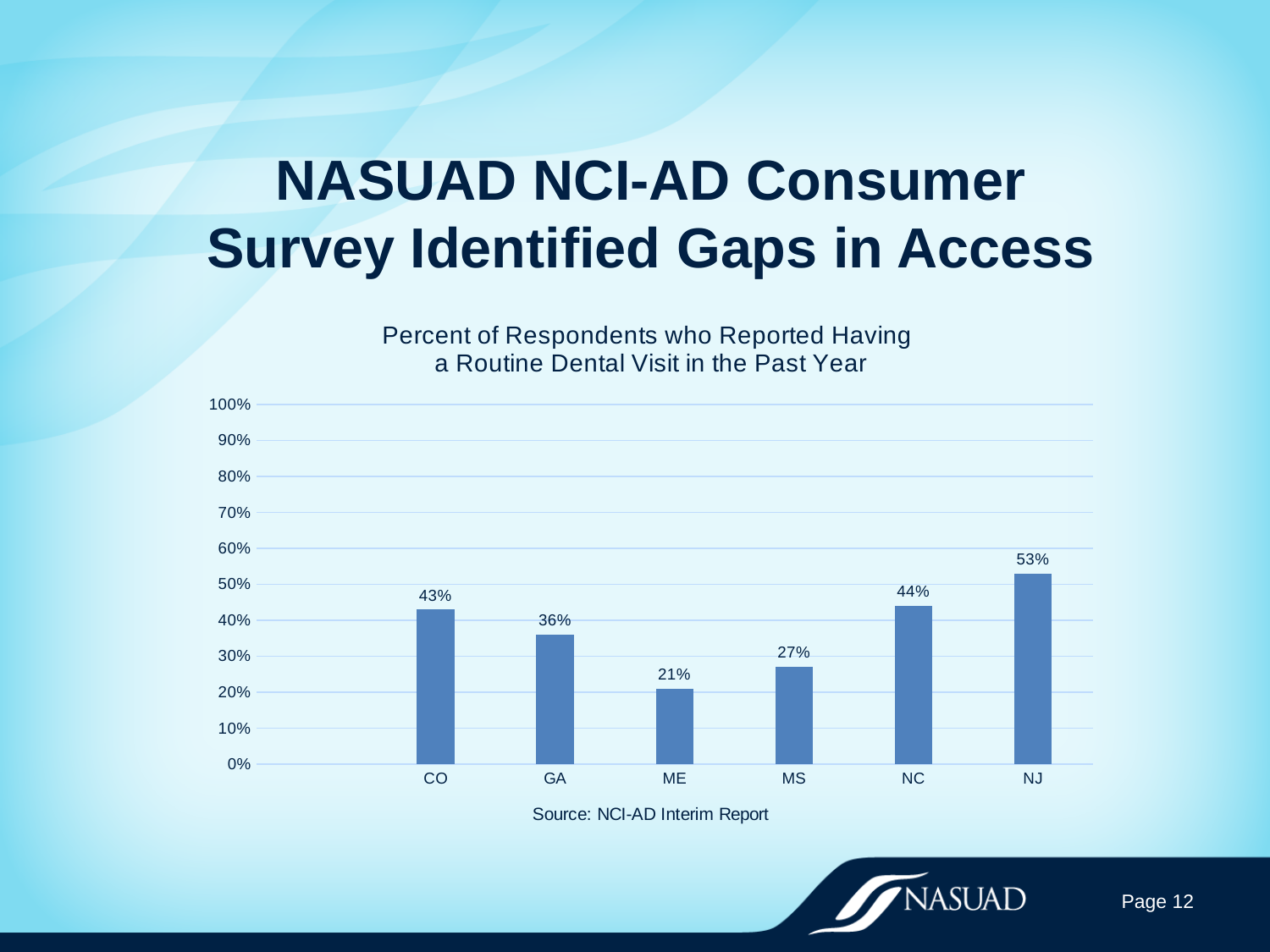
Is the value for NJ greater or less than 50%? greater What kind of chart is shown on the slide? bar chart Which state has the highest percent of respondents reporting a routine dental visit? NJ What is the value shown for NC? 44% Which state has the lowest percent of respondents reporting a routine dental visit? ME What is the title of the chart? Percent of Respondents who Reported Having a Routine Dental Visit in the Past Year What is the value shown for ME? 21% Which is larger, the value for GA or the value for MS? GA What is the difference between the values for CO and GA? 7% What is the difference between the values for NJ and ME? 32% How many states are shown on the x axis of the chart? 6 What percent of respondents in CO reported having a routine dental visit in the past year? 43%